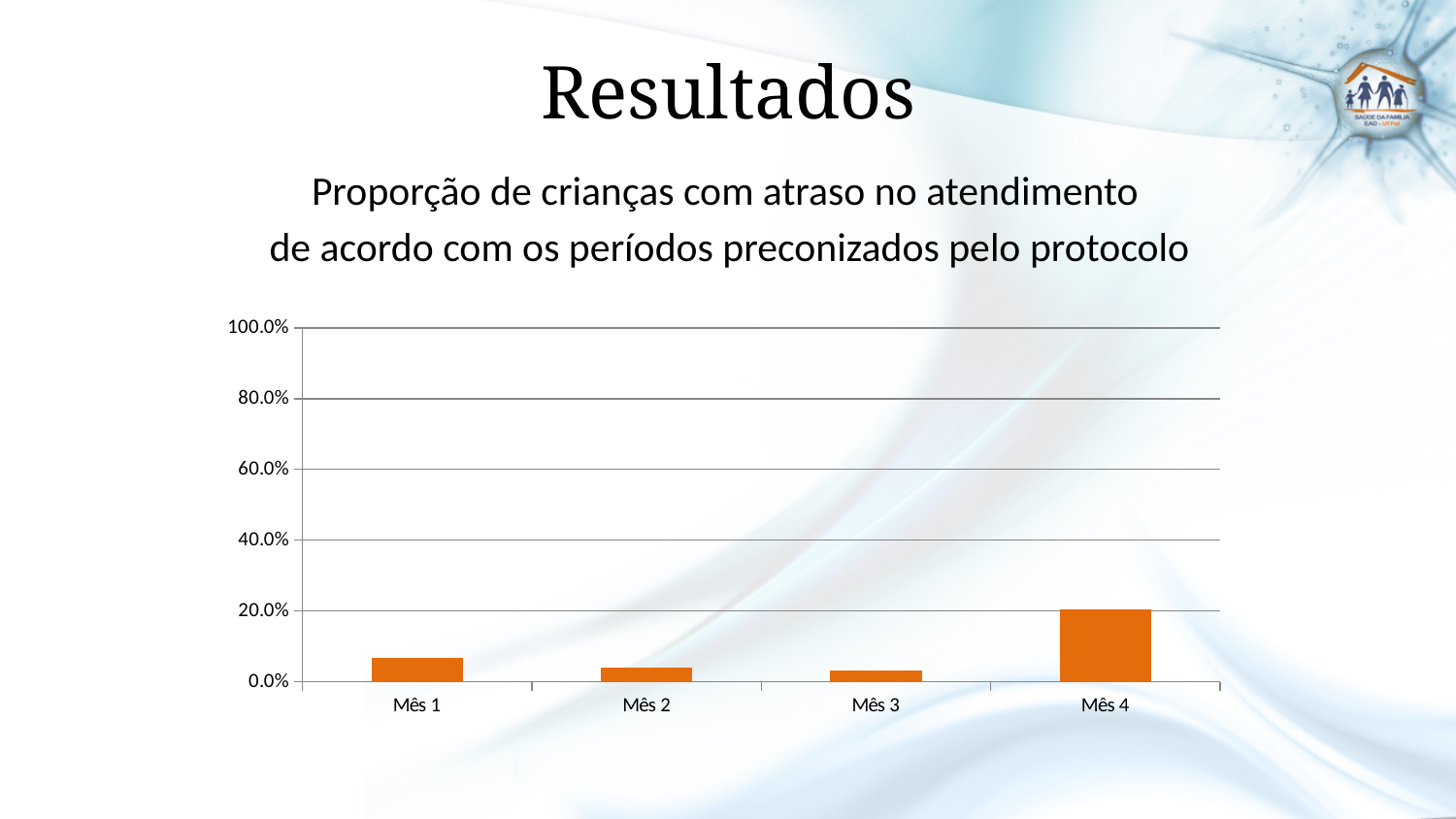
Which is larger, the value for Mês 4 or the value for Mês 3? Mês 4 Which month has the highest proportion in the chart? Mês 4 How many categories are shown on the x axis of the chart? 4 Is the value for Mês 4 greater or less than 40.0%? less Which is larger, the value for Mês 1 or the value for Mês 2? Mês 1 Does the value rise or fall from Mês 3 to Mês 4? rise What colour are the bars in the chart? orange What is the highest value shown on the y axis of the chart? 100.0% Is the value for Mês 1 greater or less than 20.0%? less Is the value for Mês 2 greater or less than 20.0%? less What kind of chart is shown on the slide? bar chart